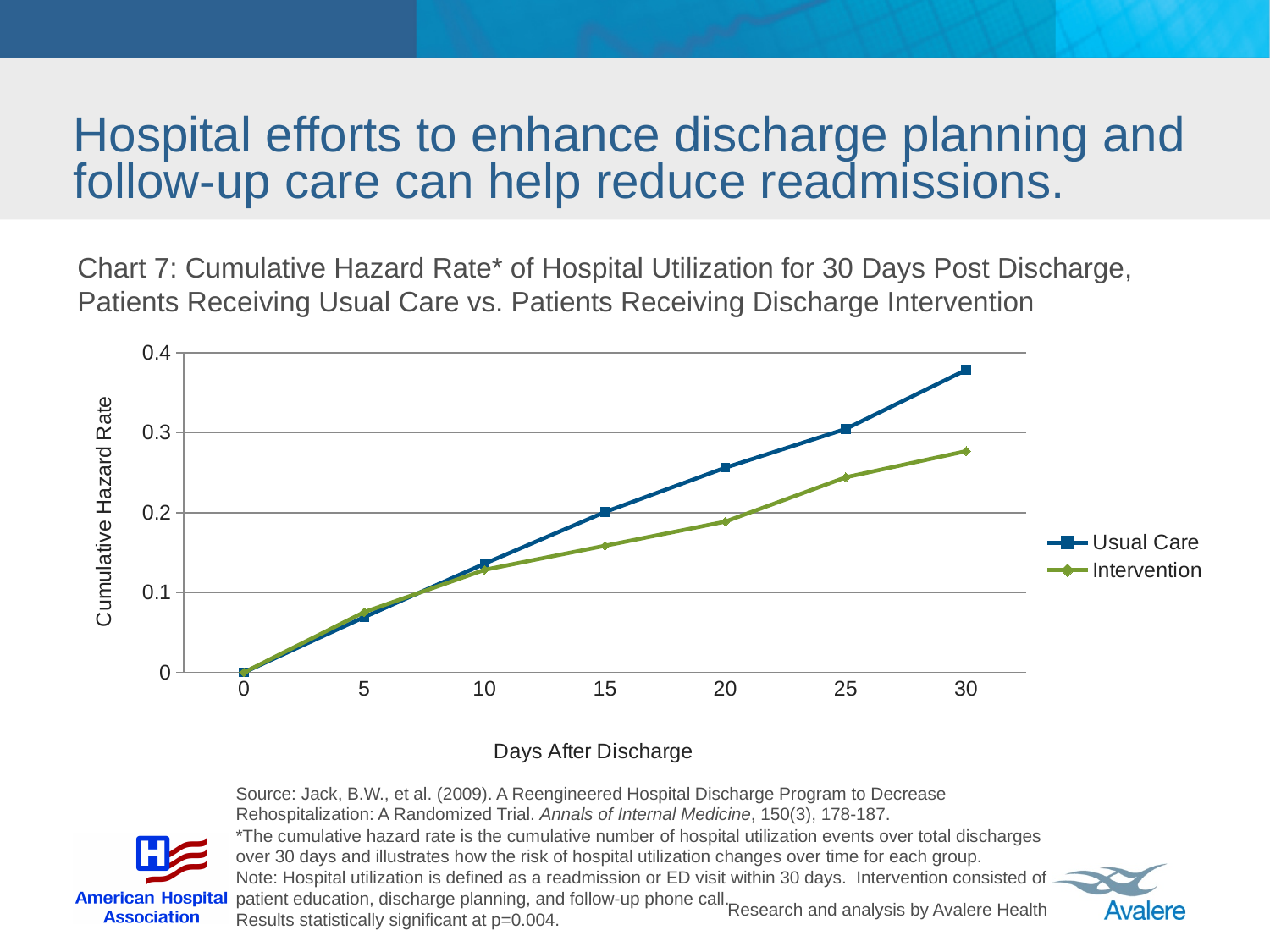
How many data points are plotted for the Usual Care series? 7 At 30 days after discharge, which series has the higher cumulative hazard rate, Usual Care or Intervention? Usual Care What kind of chart is shown on the slide? Line chart Does the cumulative hazard rate for Intervention rise or fall as days after discharge increase? Rise What is the label of the y axis? Cumulative Hazard Rate Is the value for Intervention at 25 days after discharge greater or less than 0.2? greater What is the label of the x axis? Days After Discharge How many series does the legend list? 2 Is the value for Intervention at 15 days after discharge greater or less than 0.2? less Is the value for Usual Care at 30 days after discharge greater or less than 0.3? greater